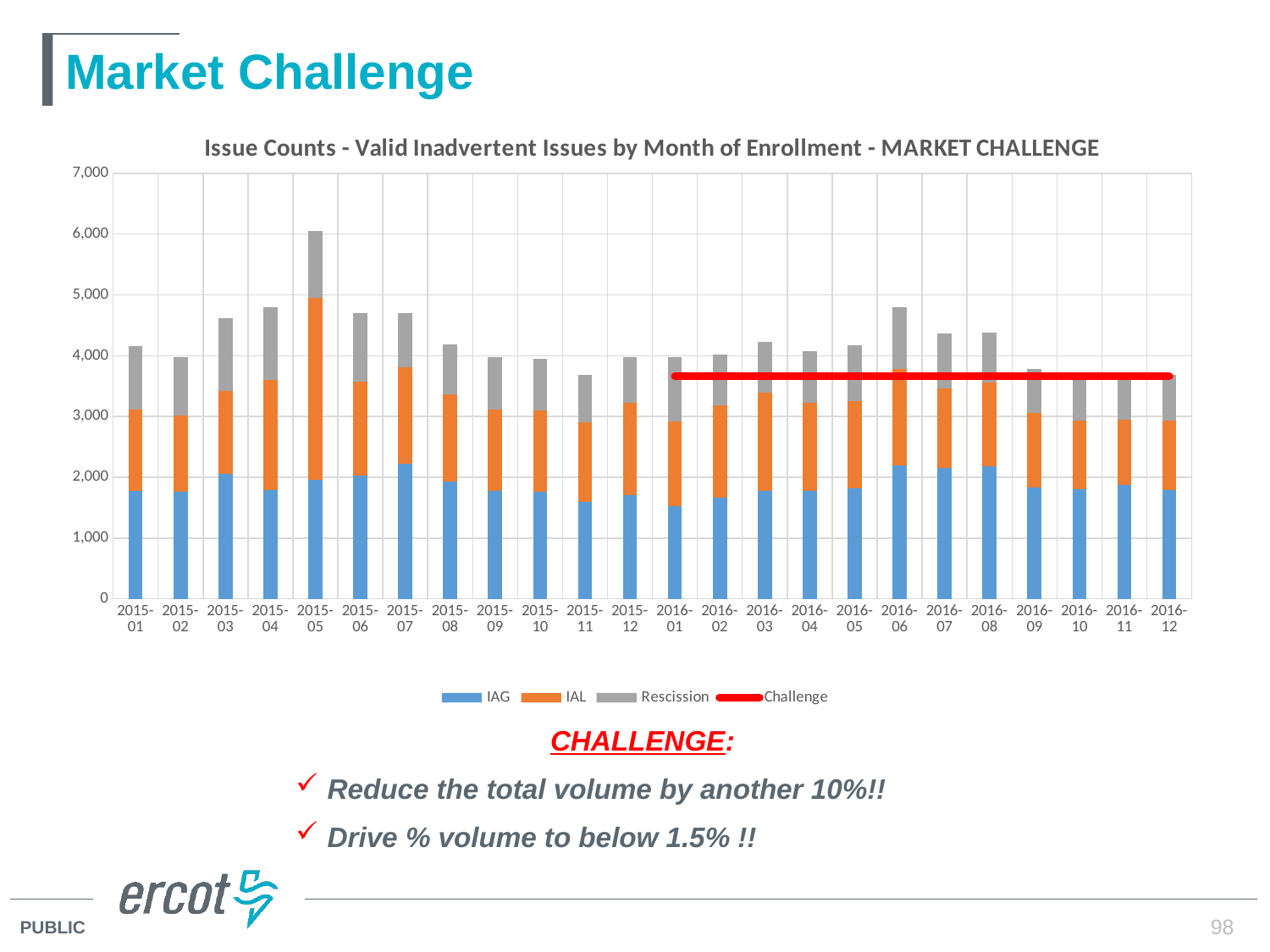
Is the IAG value for 2016-01 greater or less than 2,000? less How many series does the legend list? 4 What kind of chart is shown on the slide? Combination stacked bar and line chart Is the total stacked value for 2015-11 greater or less than 4,000? less What is the title of the chart? Issue Counts - Valid Inadvertent Issues by Month of Enrollment - MARKET CHALLENGE Is the total stacked value for 2015-05 greater or less than 5,000? greater How many months (categories) are plotted along the x axis? 24 Which month has the highest total stacked bar? 2015-05 Which legend entry is represented by the red horizontal line? Challenge Which month has the larger total stacked bar, 2015-04 or 2015-05? 2015-05